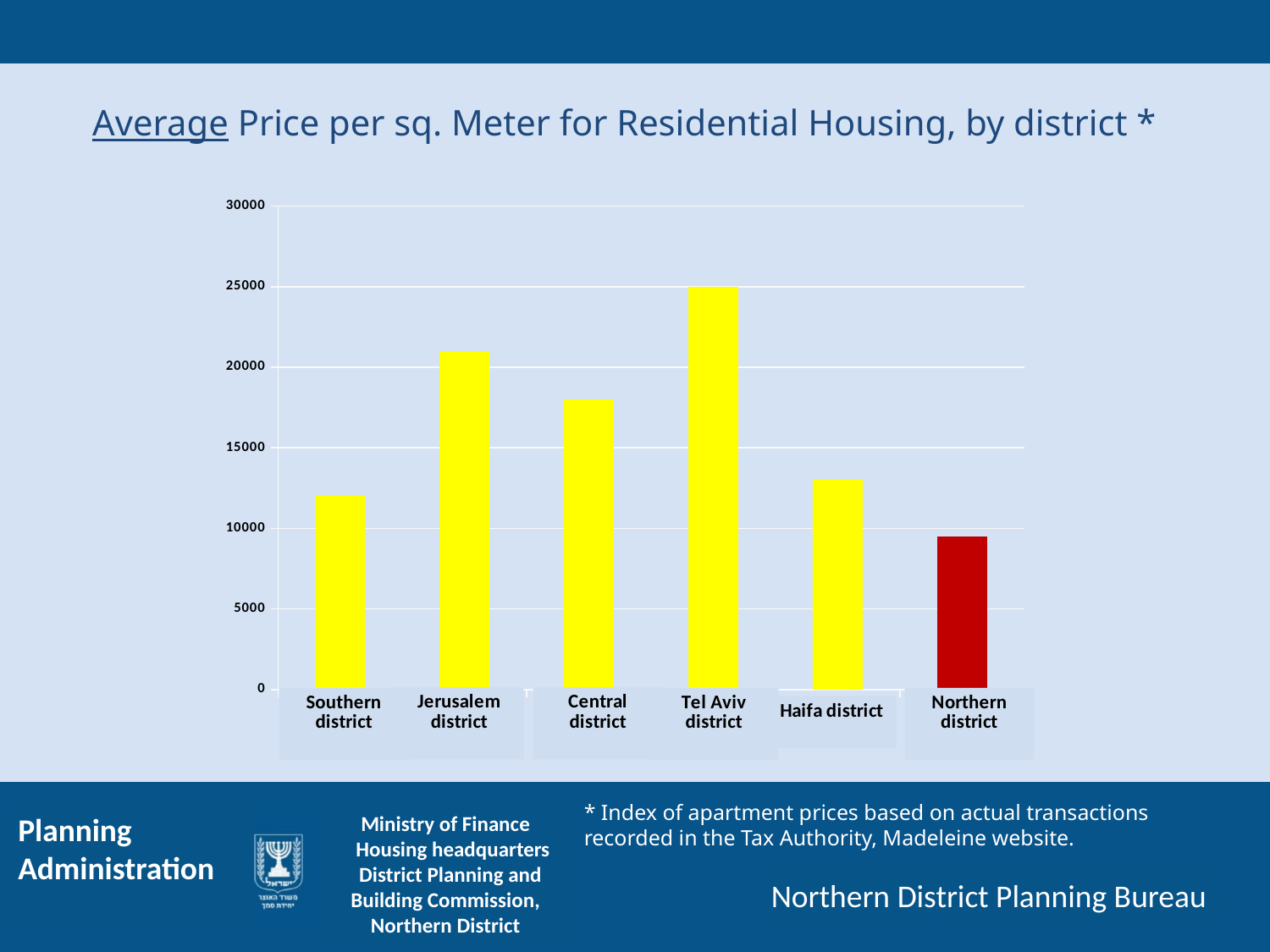
Which has a higher average price per sq. meter, Jerusalem district or Central district? Jerusalem district Is the value for Northern district greater or less than 10000? less Is the value for Central district greater or less than 15000? greater Is the value for Tel Aviv district greater or less than 20000? greater What is the title of the chart? Average Price per sq. Meter for Residential Housing, by district * Which district has the highest average price per sq. meter? Tel Aviv district Which district has the lowest average price per sq. meter? Northern district Which has a higher average price per sq. meter, Southern district or Haifa district? Haifa district What kind of chart is shown on the slide? bar chart Which district's bar is coloured red instead of yellow? Northern district How many districts are shown on the chart? 6